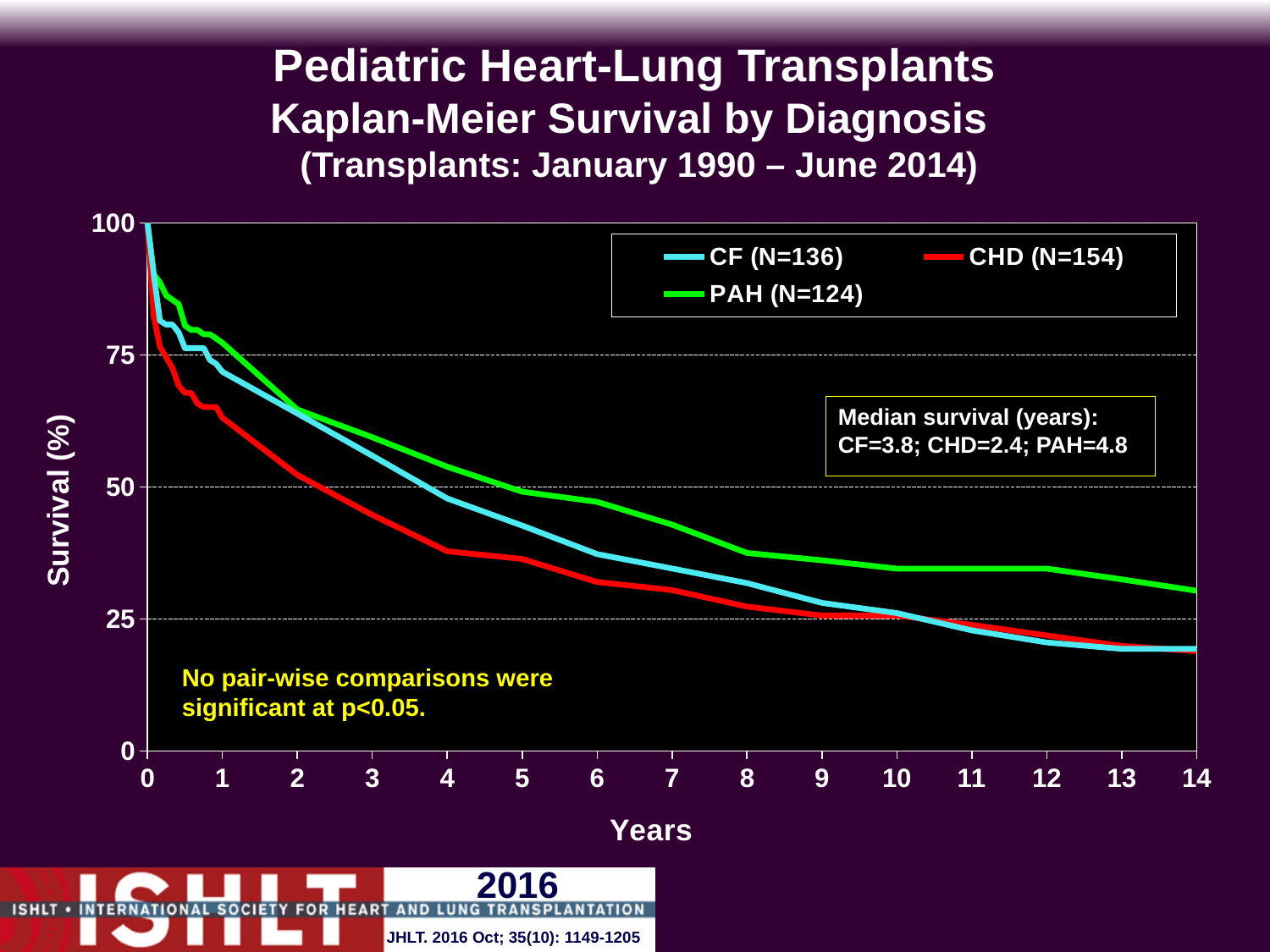
Is the survival for PAH at 14 years greater or less than 25? greater At 6 years, is survival higher for PAH or for CHD? PAH Which diagnosis group has the lowest survival at 4 years? CHD How many patients (N) are in the CHD group according to the legend? 154 Which diagnosis group has the highest survival at 8 years? PAH What kind of chart is shown on the slide? Line chart What is the median survival in years for the CHD group, as stated on the slide? 2.4 Is the survival for CHD at 4 years greater or less than 50? less How many series does the legend list? 3 Do the survival curves rise or fall as years increase? Fall What is the median survival in years for the CF group, as stated on the slide? 3.8 What is the median survival in years for the PAH group, as stated on the slide? 4.8